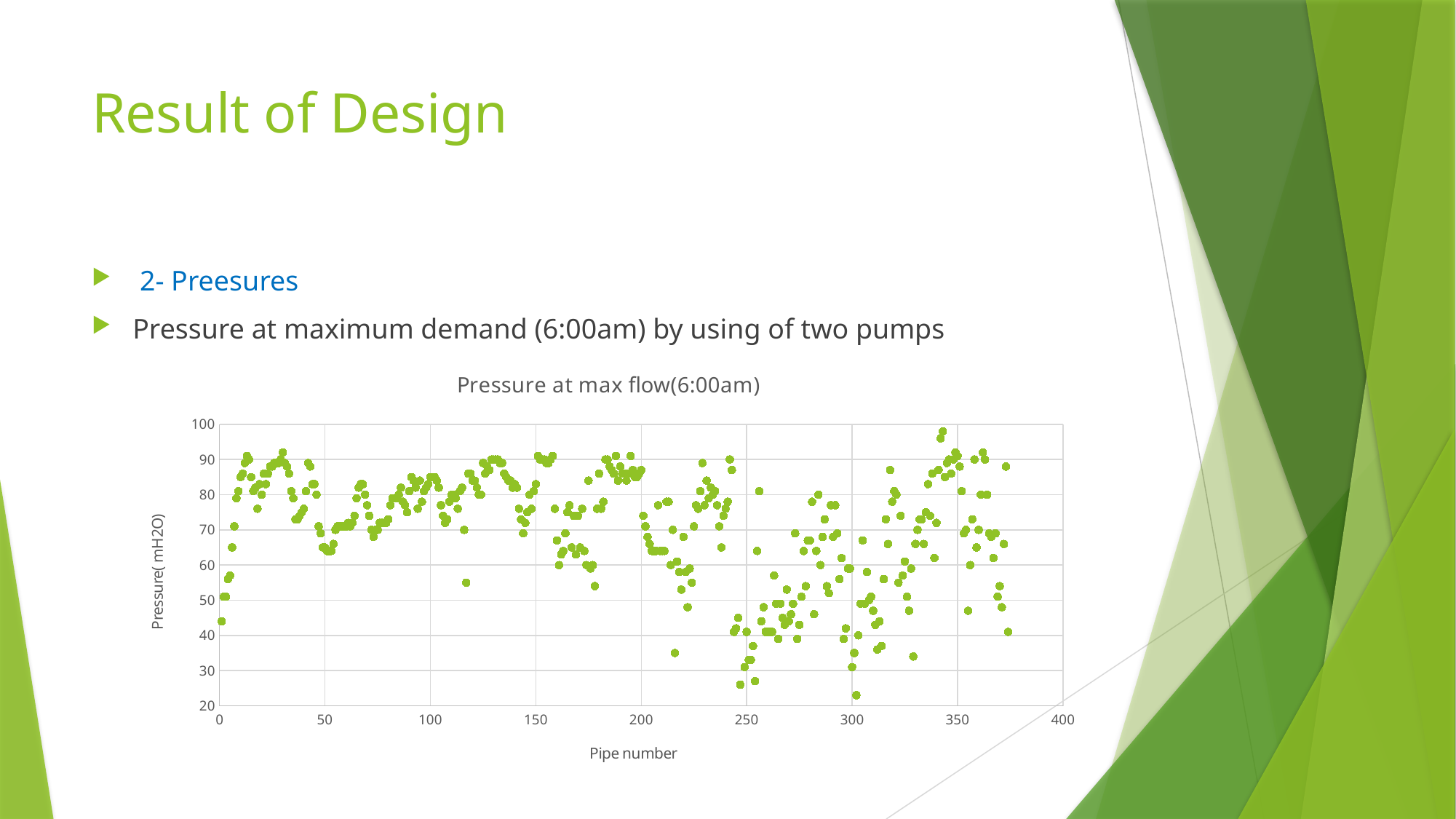
What is the title of the chart? Pressure at max flow(6:00am) Is the pressure for the pipe with the lowest value, near pipe number 300, greater or less than 30? less Is the pressure for the highest point, near pipe number 345, greater or less than 90? greater What is the label of the vertical axis of the chart? Pressure( mH2O) What kind of chart is shown on the slide? scatter chart Is the highest plotted pressure value in the chart greater or less than 95? greater